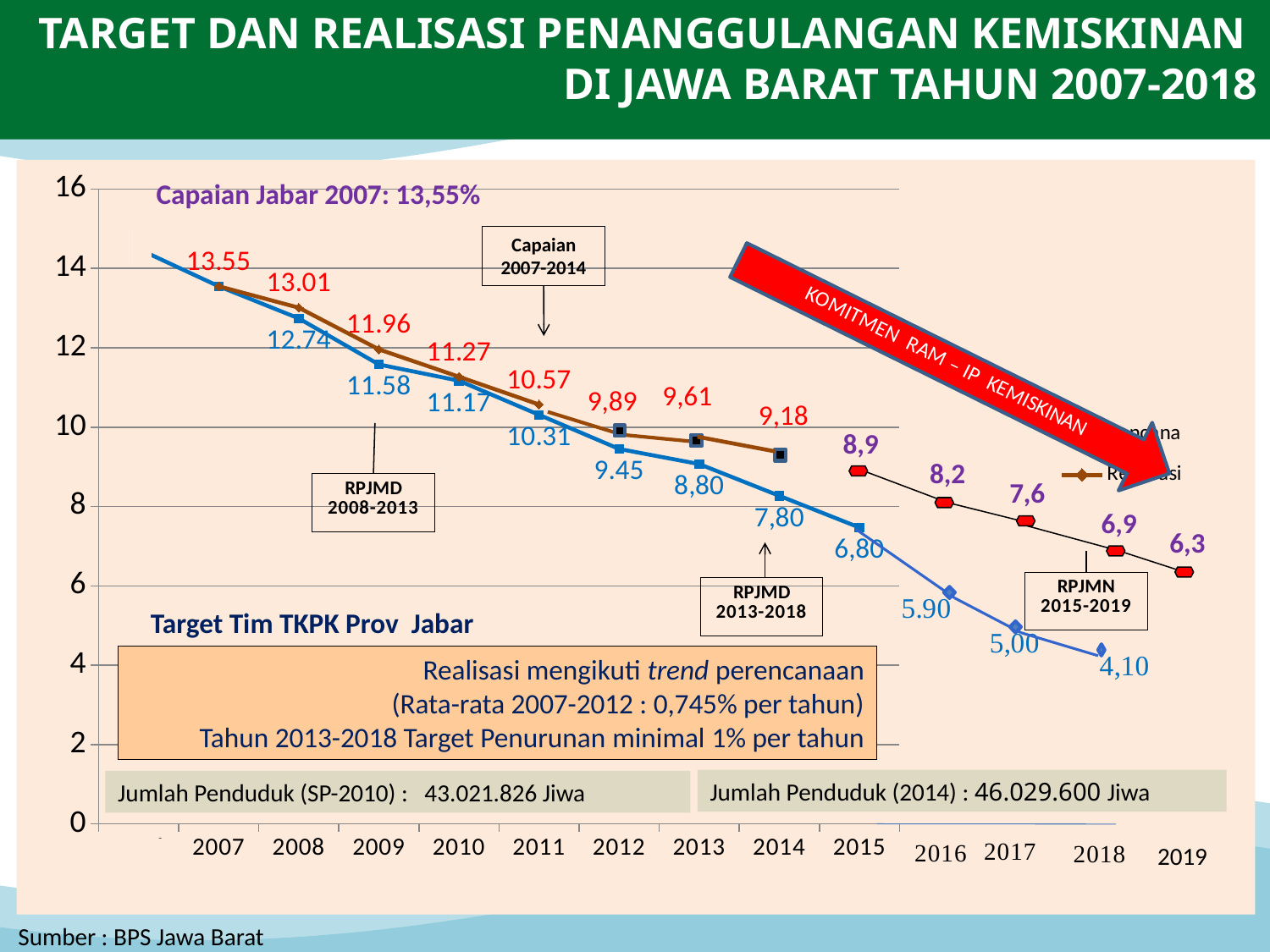
In 2012, which is larger: the Realisasi value (9,89) or the blue line value (9.45)? Realisasi (9,89) By how much did the Realisasi value fall from 2007 (13.55) to 2008 (13.01)? 0.54 What is the Realisasi (brown line) value for 2007? 13.55 What is the value of the blue line for 2018? 4,10 In which year is the Realisasi (brown line) value highest? 2007 What is the value of the blue line for 2011? 10.31 What is the Realisasi (brown line) value for 2014? 9,18 In which year does the blue line reach its lowest value? 2018 What kind of chart is shown on the slide? Line chart Do the plotted values rise or fall from 2007 to 2019? Fall What is the value of the red-marker series for 2019? 6,3 What is the difference between the red-marker values for 2015 (8,9) and 2019 (6,3)? 2,6